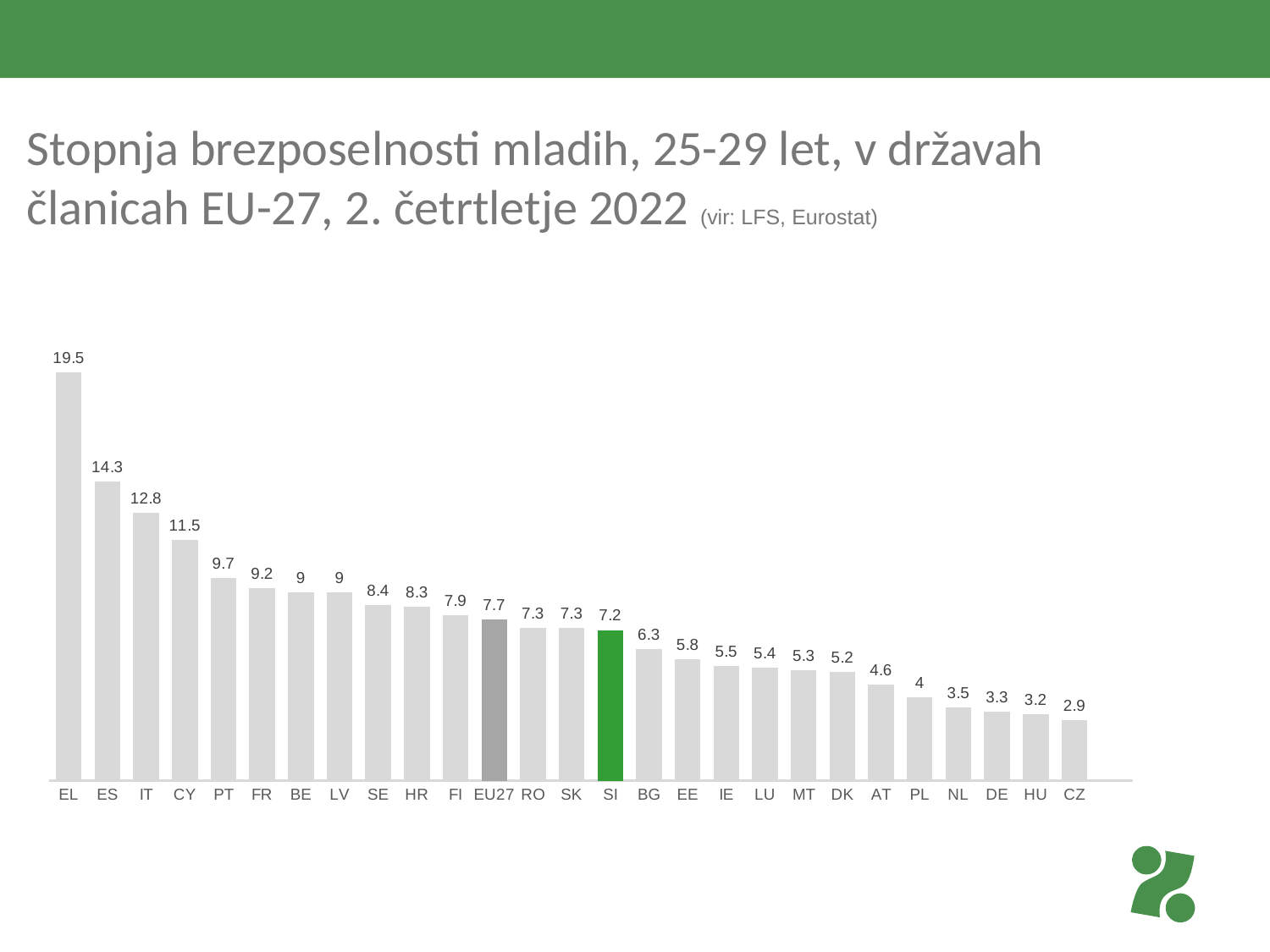
How many categories are shown on the x axis? 27 Which category has the highest value? EL What is the difference between the values for EL and ES? 5.2 What is the value for EU27? 7.7 Which category has the lowest value? CZ What is the value for PT? 9.7 Which bar is coloured green? SI What is the difference between the values for EU27 and SI? 0.5 Which is larger, the value for IT or the value for CY? IT Do the values rise or fall from left to right along the x axis? fall What is the value for SI? 7.2 What kind of chart is this? bar chart